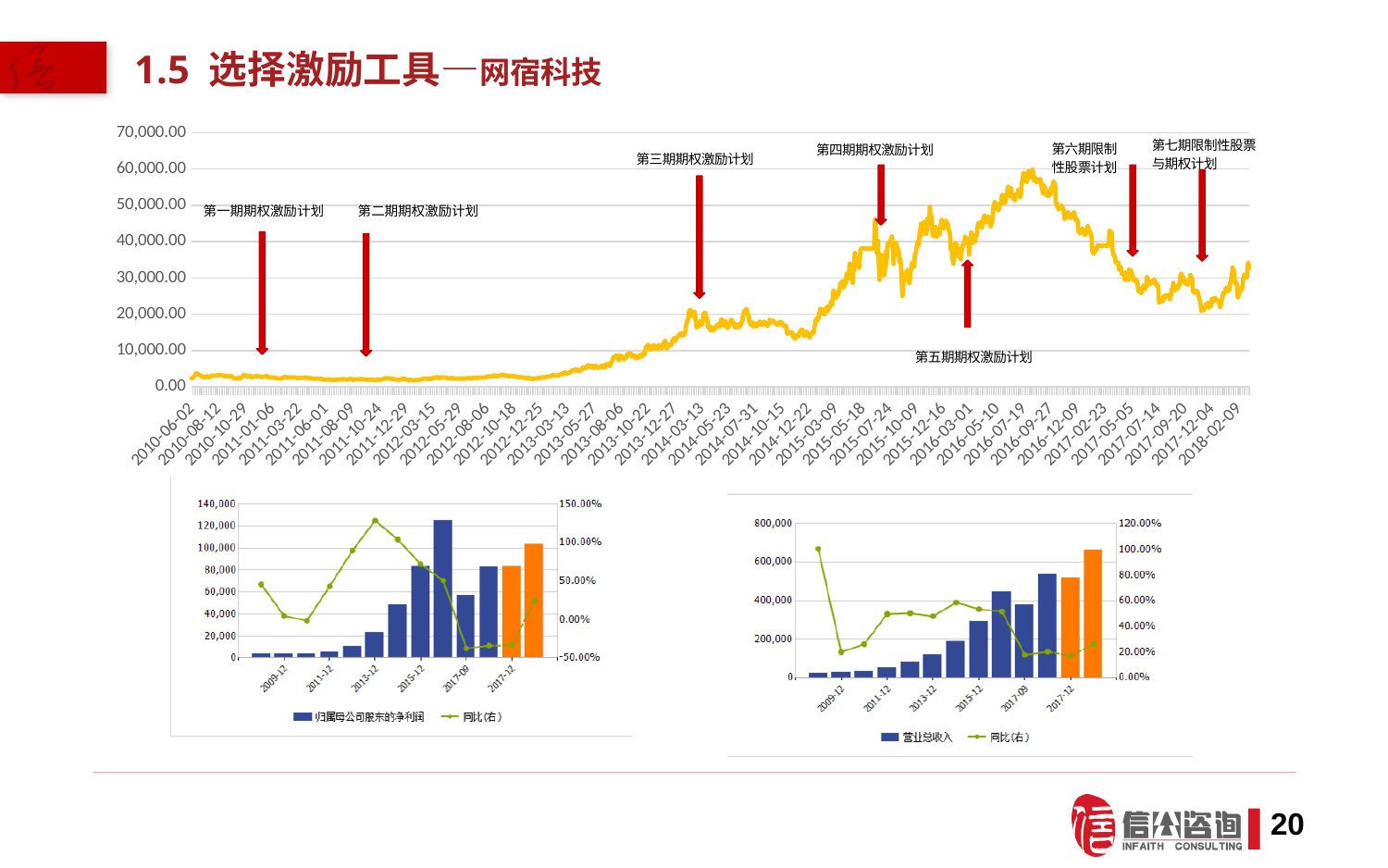
In the bottom-right chart, do the bars generally rise or fall from 2009-12 to 2017-12? rise In the top chart, is the value at 2018-02-09 greater or less than 20,000.00? greater How many series does the legend of the bottom-left chart list? 2 What kind of chart is the top chart on the slide? line chart In the top chart, does the line generally rise or fall between 2016-07-19 and 2017-12-04? fall What colour is the line in the top chart? yellow What are the two legend entries of the bottom-right chart? 营业总收入 and 同比(右) In the bottom-right chart, is the bar for 2009-12 greater or less than 200,000? less In the top chart, is the value at 2010-06-02 greater or less than 10,000.00? less In the top chart, how many incentive plans (激励计划) are annotated with arrows? 7 In the top chart, does the line generally rise or fall between 2013-01 and 2016-07? rise